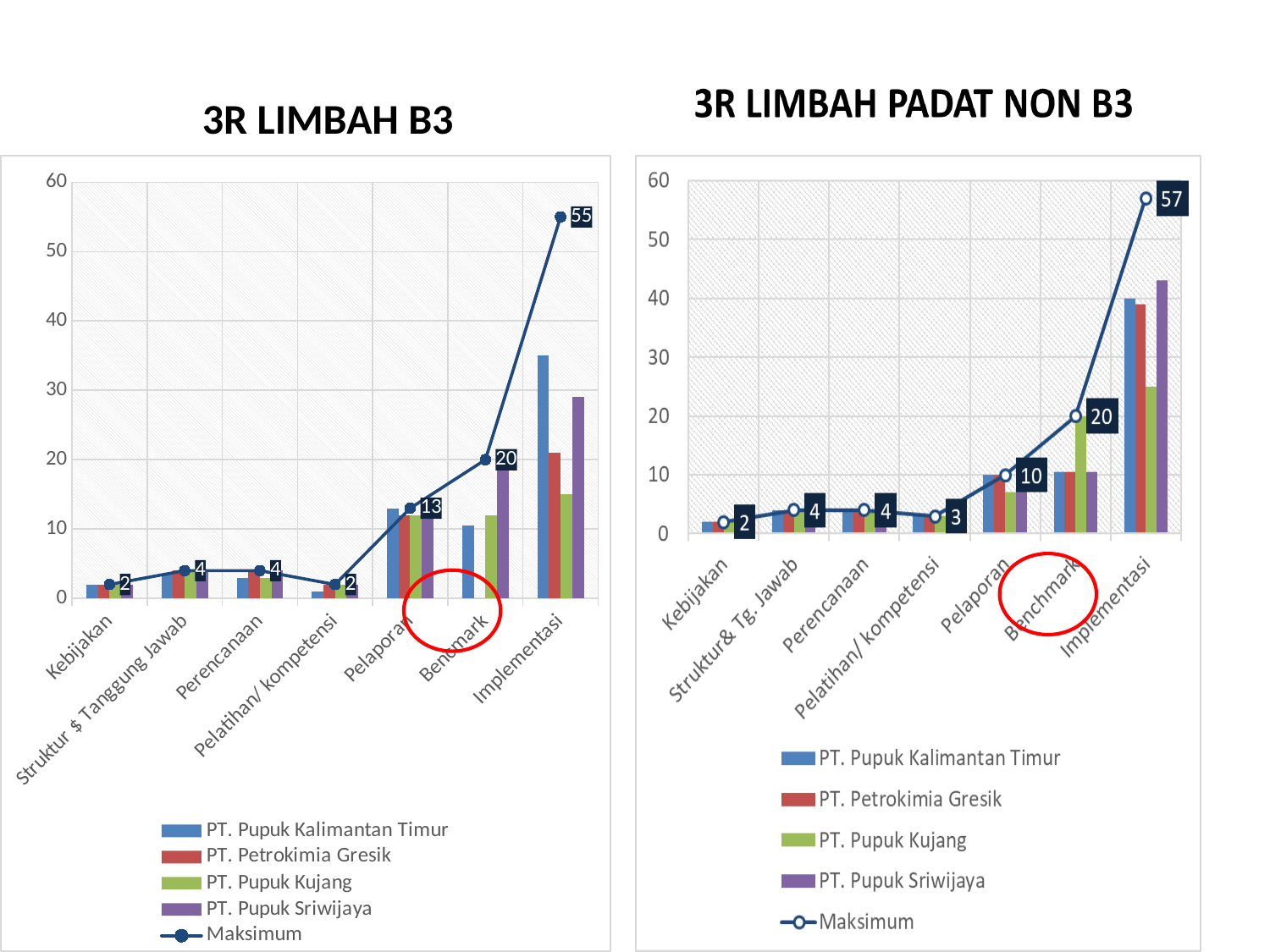
In the 3R LIMBAH B3 chart, is the Maksimum value for Benchmark larger or smaller than the Maksimum value for Pelaporan? larger In the 3R LIMBAH B3 chart, what is the Maksimum value for Pelaporan? 13 In the 3R LIMBAH PADAT NON B3 chart, what is the difference between the Maksimum values for Implementasi and Benchmark? 37 In the 3R LIMBAH PADAT NON B3 chart, what is the Maksimum value for Pelatihan/ kompetensi? 3 In the 3R LIMBAH PADAT NON B3 chart, what is the Maksimum value for Implementasi? 57 In the 3R LIMBAH B3 chart, what is the Maksimum value for Implementasi? 55 How many series does the legend of the 3R LIMBAH B3 chart list? 5 In the 3R LIMBAH PADAT NON B3 chart, is the value for PT. Pupuk Kujang at Implementasi greater or less than 30? less How many categories are shown on the x axis of the 3R LIMBAH PADAT NON B3 chart? 7 What kind of chart is the 3R LIMBAH PADAT NON B3 chart? A combined bar and line chart In the 3R LIMBAH B3 chart, is the value for PT. Pupuk Kalimantan Timur at Implementasi greater or less than 30? greater In the 3R LIMBAH B3 chart, which category has the highest Maksimum value? Implementasi